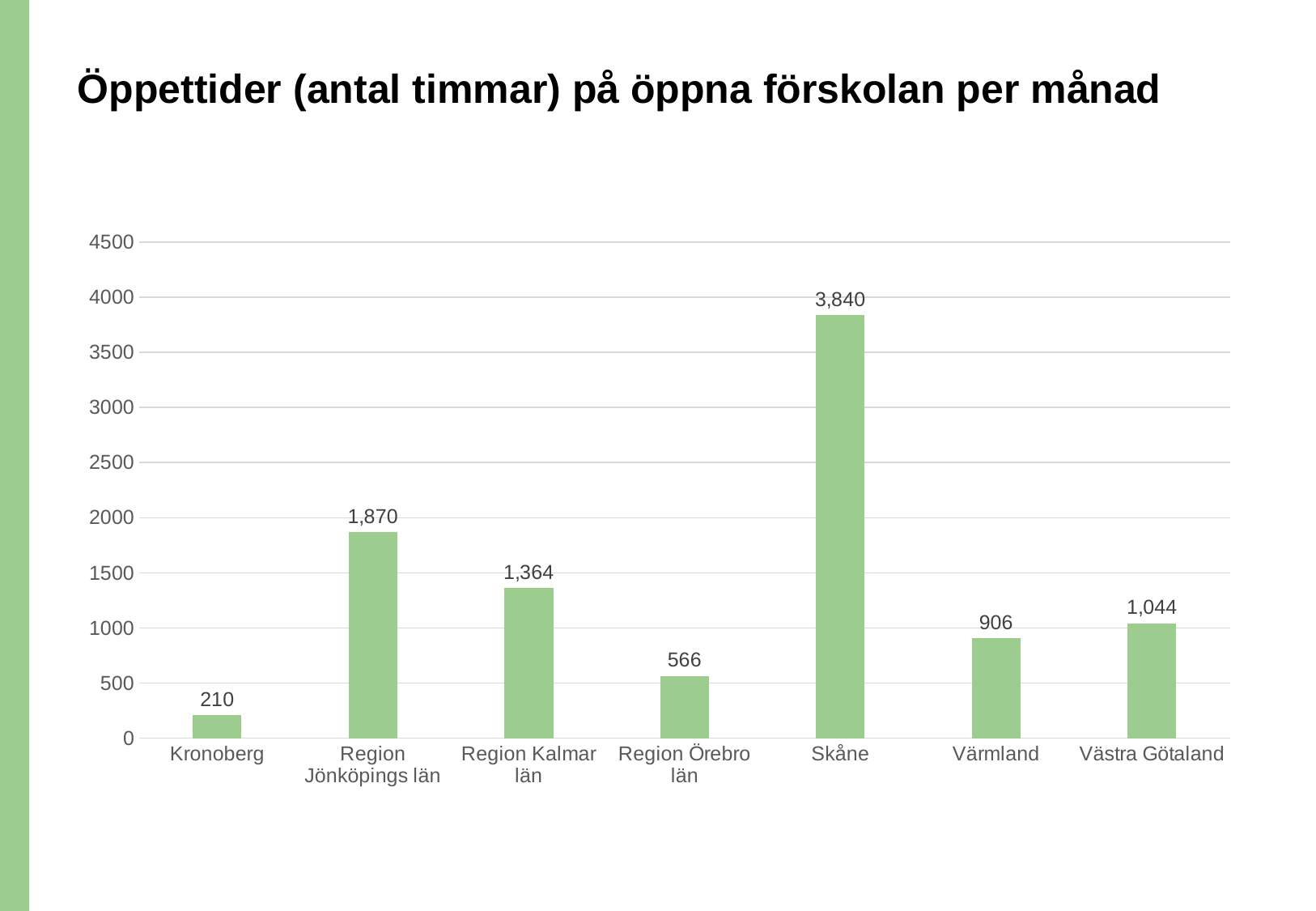
Is the value for Region Jönköpings län greater or less than 1500? greater Which is larger, the value for Region Örebro län or the value for Värmland? Värmland What kind of chart is shown on the slide? bar chart What is the difference between the values for Västra Götaland and Värmland? 138 Which category has the highest value? Skåne What is the value for Värmland? 906 What is the difference between the values for Skåne and Region Jönköpings län? 1,970 What is the value for Region Kalmar län? 1,364 How many categories are shown on the x axis? 7 Which category has the lowest value? Kronoberg What is the title of the slide? Öppettider (antal timmar) på öppna förskolan per månad What is the value for Skåne? 3,840